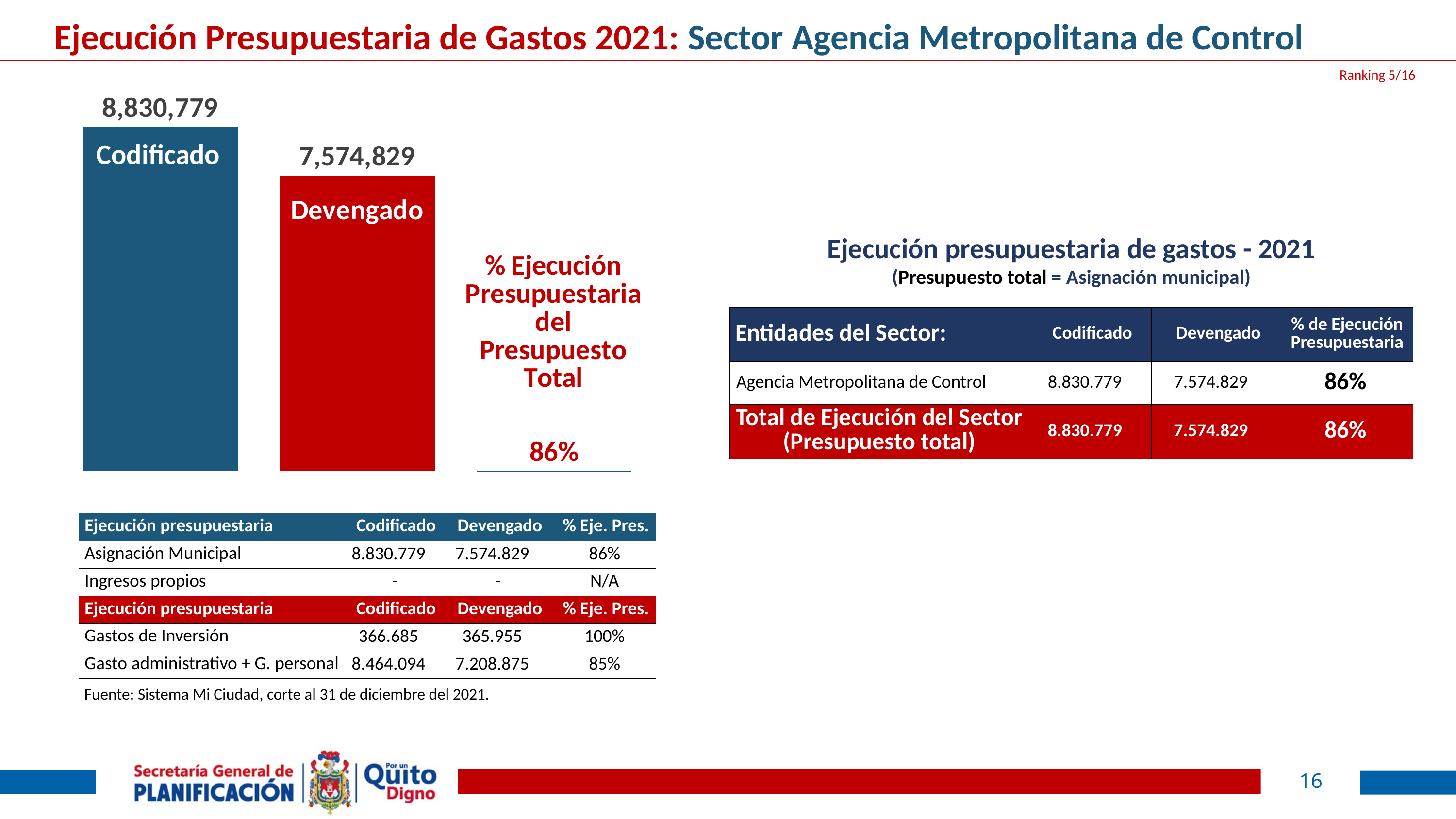
Which bar in the chart is the lowest? Devengado How many bars are plotted in the chart? 2 What is the value of the Codificado bar in the chart? 8,830,779 What colour is the Codificado bar in the chart? Blue What percentage is shown next to the chart as the % Ejecución Presupuestaria del Presupuesto Total? 86% What colour is the Devengado bar in the chart? Red What kind of chart is shown on the slide? Bar chart Which is larger in the chart, Codificado or Devengado? Codificado What is the difference between the Codificado and Devengado values in the chart? 1,255,950 Which bar in the chart is the highest? Codificado What is the value of the Devengado bar in the chart? 7,574,829